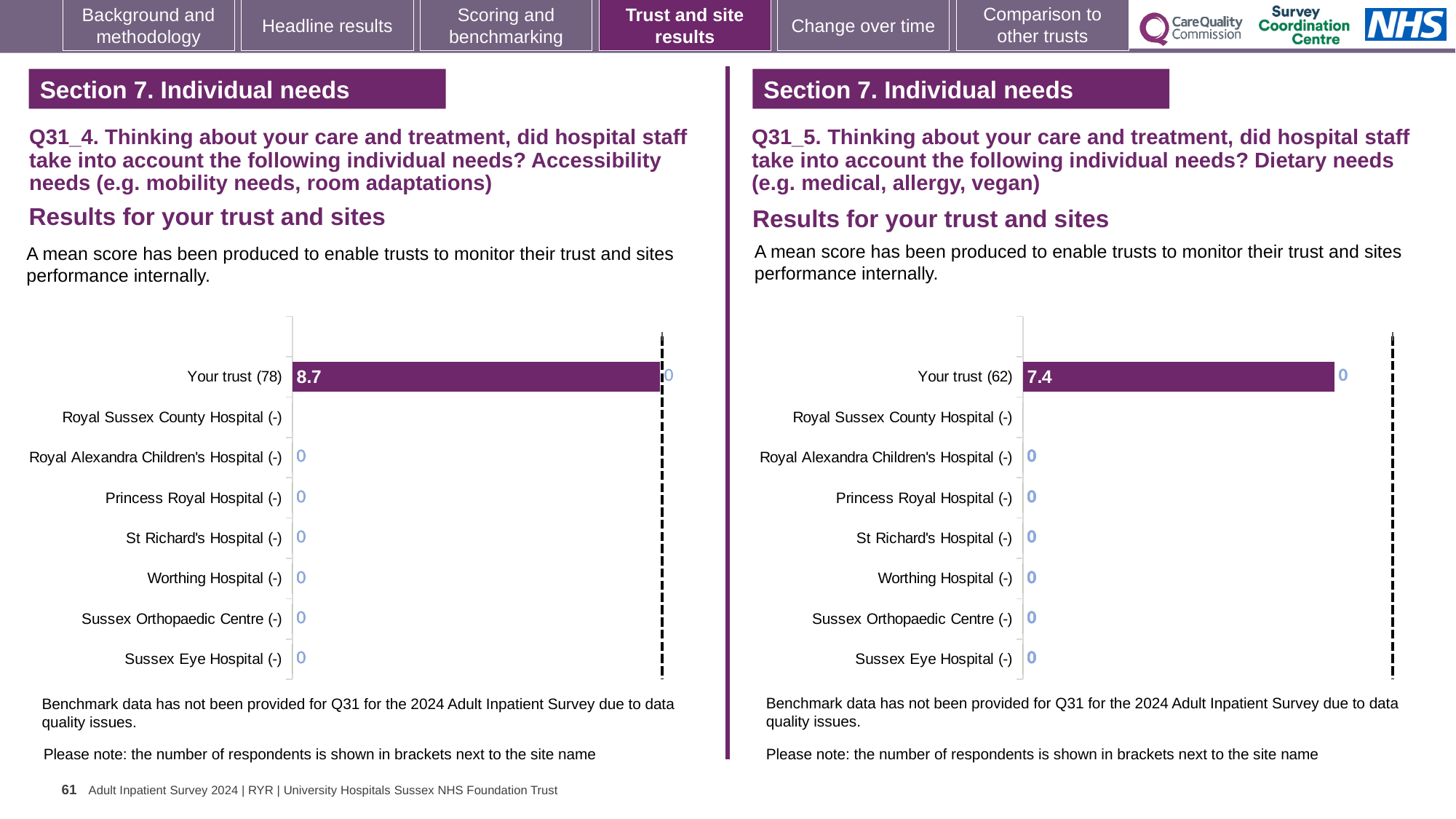
Which chart shows the higher mean score for Your trust, the left chart (Q31_4, Accessibility needs) or the right chart (Q31_5, Dietary needs)? The left chart (Q31_4, Accessibility needs) In the right chart (Q31_5, Dietary needs), which category has the highest mean score? Your trust In the left chart (Q31_4, Accessibility needs), what is the mean score for Your trust? 8.7 In the left chart (Q31_4, Accessibility needs), how many respondents are shown in brackets for Your trust? 78 What kind of chart is used in the left chart (Q31_4, Accessibility needs)? Bar chart How many categories are listed on the vertical axis of the right chart (Q31_5, Dietary needs)? 8 In the left chart (Q31_4, Accessibility needs), is the mean score for Your trust greater or less than 8? greater How many categories are listed on the vertical axis of the left chart (Q31_4, Accessibility needs)? 8 What is the difference between the Your trust mean score in the left chart (Q31_4) and the Your trust mean score in the right chart (Q31_5)? 1.3 In the left chart (Q31_4, Accessibility needs), which category is listed directly below Your trust? Royal Sussex County Hospital In the right chart (Q31_5, Dietary needs), what is the mean score for Your trust? 7.4 In the right chart (Q31_5, Dietary needs), how many respondents are shown in brackets for Your trust? 62